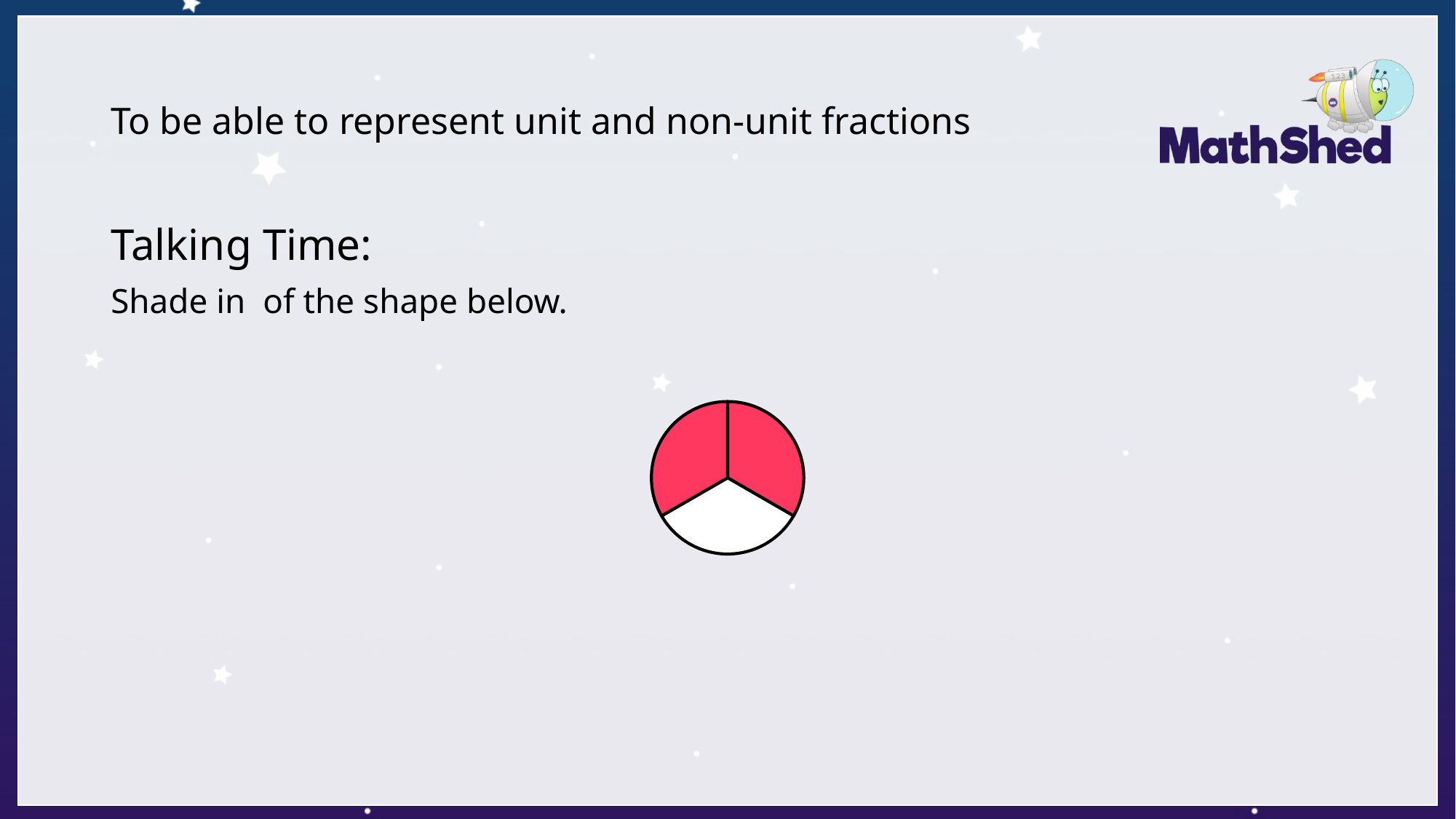
What colour are the shaded sections of the circle? Pink How many sections of the circle are shaded? 2 Are more sections of the circle shaded or unshaded? Shaded What shape is divided into parts on the slide? A circle What fraction of the circle is shaded? 2/3 How many equal sections is the circle divided into? 3 What fraction of the circle is unshaded? 1/3 How many sections of the circle are left unshaded? 1